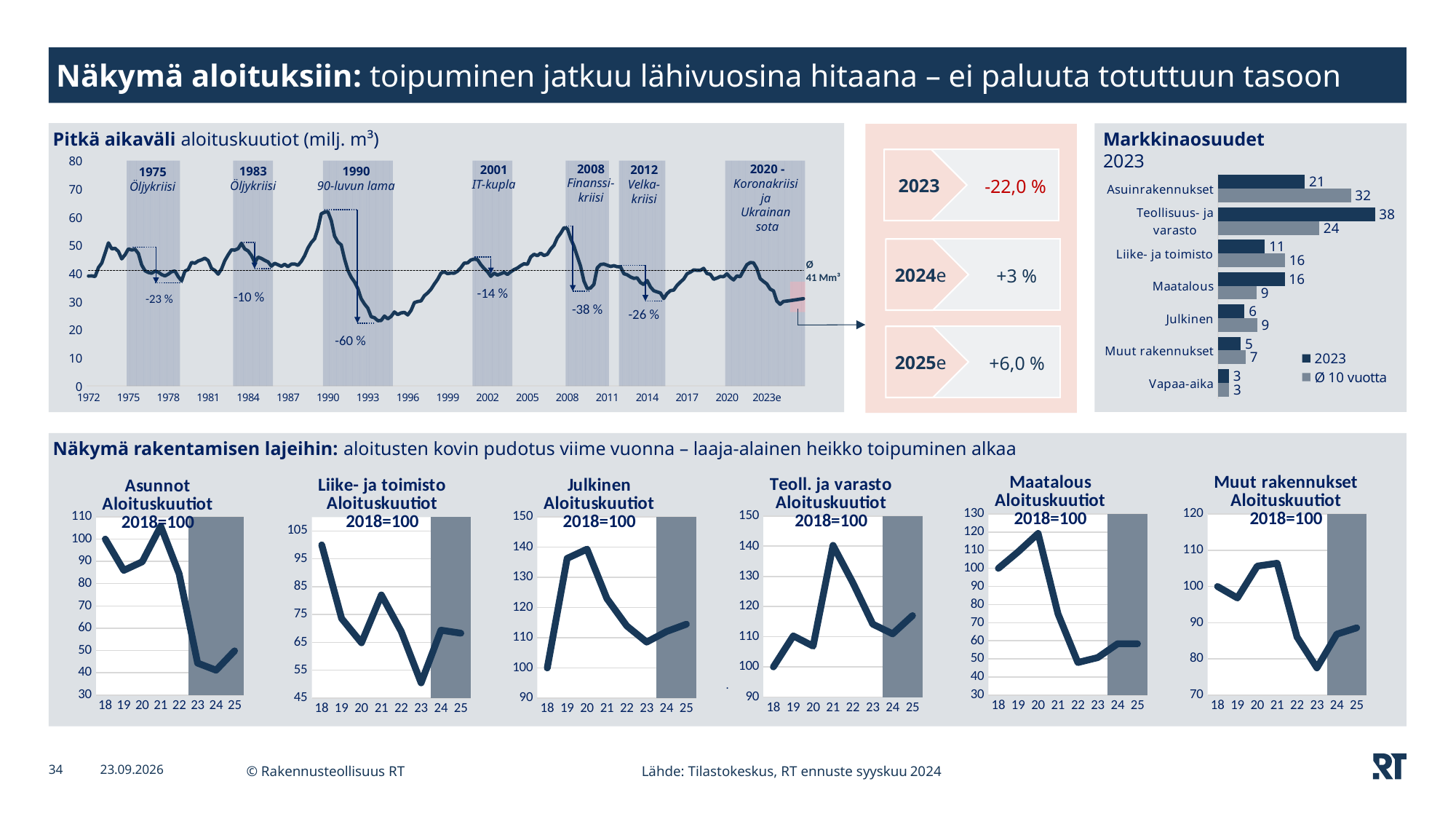
In the Markkinaosuudet 2023 chart, what is the difference between the Ø 10 vuotta and 2023 values for Asuinrakennukset? 11 In the Julkinen Aloituskuutiot 2018=100 chart, is the value for 20 greater or less than 130? greater In the Markkinaosuudet 2023 chart, which category has the lowest 2023 value? Vapaa-aika In the Markkinaosuudet 2023 chart, which is larger for Maatalous: the 2023 value or the Ø 10 vuotta value? 2023 In the Markkinaosuudet 2023 chart, what is the 2023 value for Teollisuus- ja varasto? 38 In the Asunnot Aloituskuutiot 2018=100 chart, is the value for 23 greater or less than 50? less How many series does the legend of the Markkinaosuudet 2023 chart list? 2 What kind of chart is the Pitkä aikaväli aloituskuutiot chart? line chart In the Markkinaosuudet 2023 chart, which category has the highest 2023 value? Teollisuus- ja varasto In the Pitkä aikaväli aloituskuutiot chart, what percentage drop is annotated for the 1990 90-luvun lama? -60 % In the Markkinaosuudet 2023 chart, what is the Ø 10 vuotta value for Asuinrakennukset? 32 How many categories does the Markkinaosuudet 2023 chart show? 7